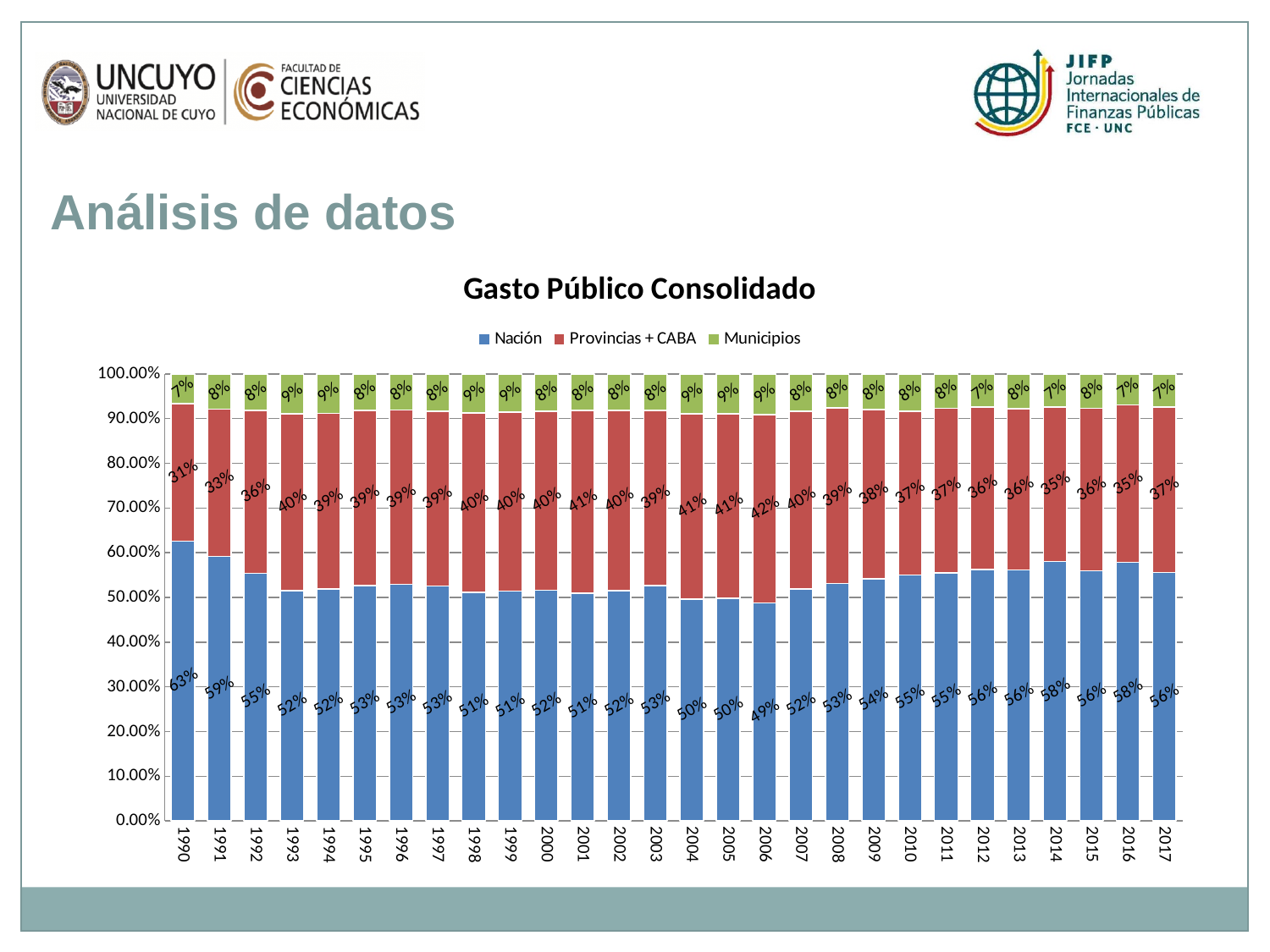
What is the value for Provincias + CABA in 2006? 42% What is the title of the chart? Gasto Público Consolidado What is the difference between the Nación share in 1990 and in 2006? 14% What is the value for Nación in 1990? 63% In which year is the Nación share the lowest? 2006 How many series does the legend list? 3 How many years are shown on the x axis? 28 Which is larger, the Provincias + CABA share in 1990 or in 2017? 2017 In which year is the Nación share the highest? 1990 What type of chart is shown on the slide? Stacked bar chart What is the value for Municipios in 2017? 7% Does the Nación share rise or fall from 1990 to 1993? Fall